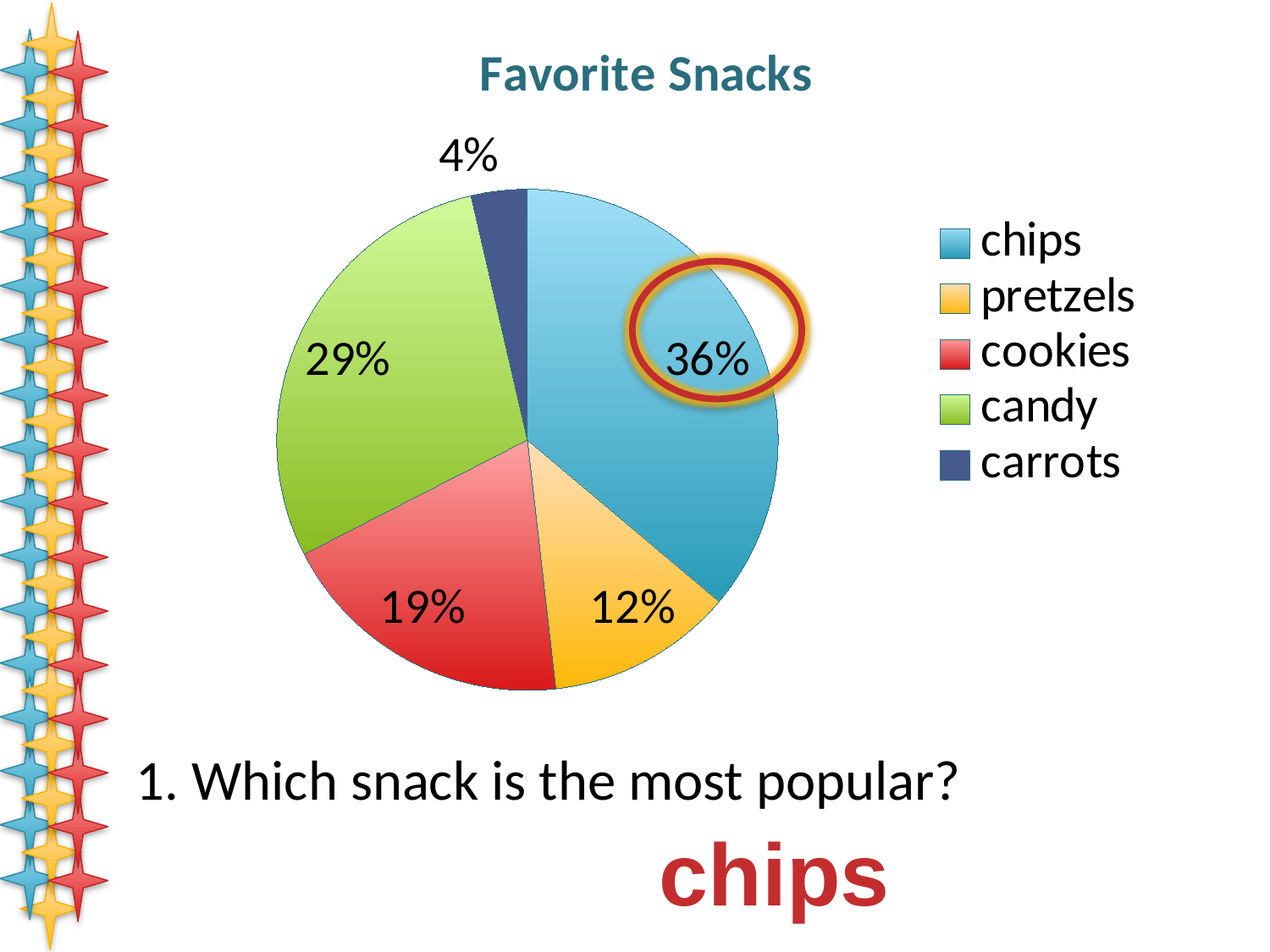
What share of the pie does chips have? 36% What share of the pie does candy have? 29% What share of the pie does pretzels have? 12% Which snack has the smallest slice of the pie? carrots What is the difference in percentage points between chips and candy? 7 What is the title of the chart? Favorite Snacks How many snack categories are shown in the pie chart? 5 What kind of chart is shown on the slide? pie chart Which has a larger share, cookies or pretzels? cookies Which snack has the largest slice of the pie? chips